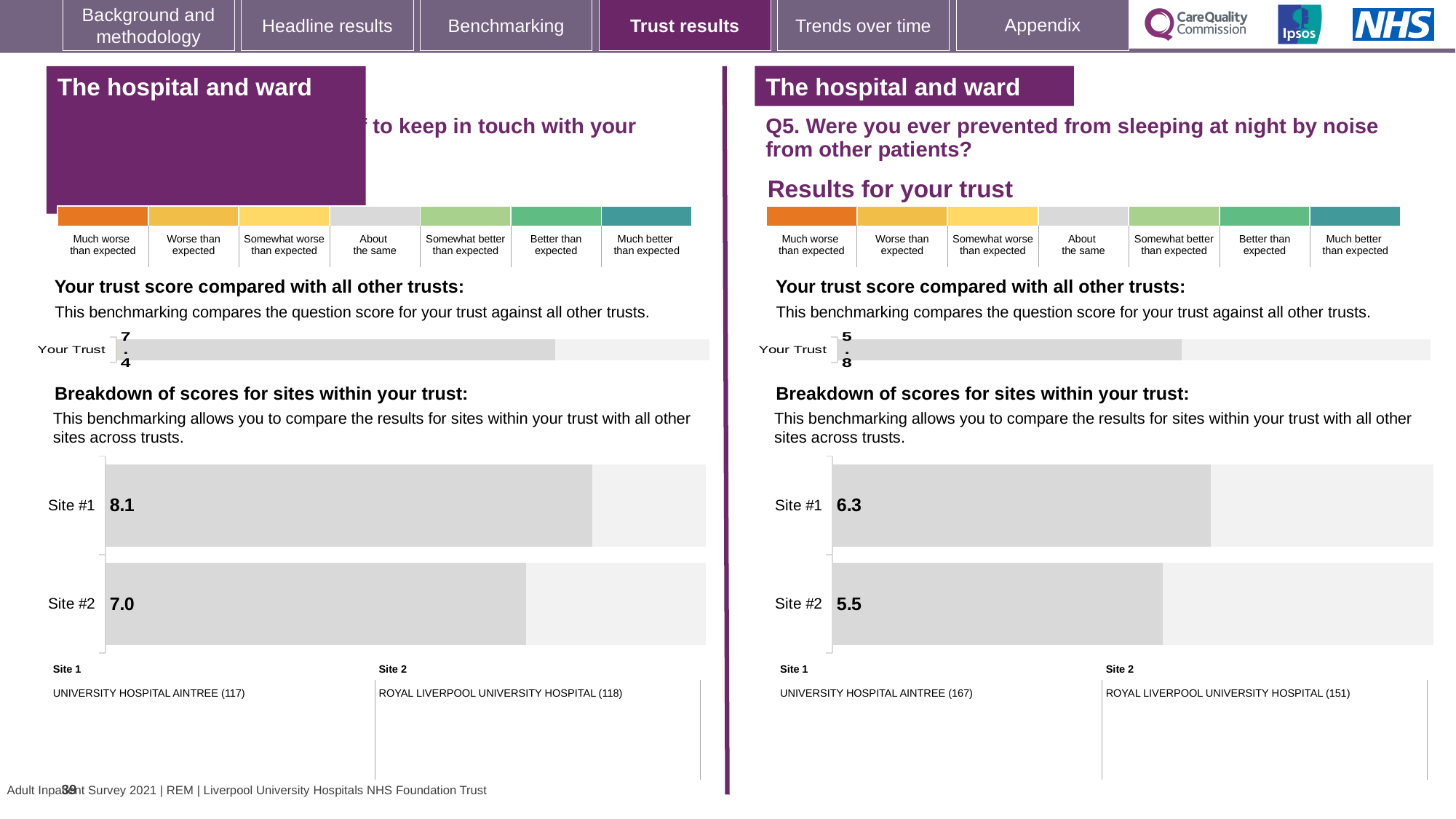
On the right-hand side of the slide (Q5), what is the 'Your Trust' score? 5.8 On the left-hand site breakdown chart, what is the difference between the Site #1 and Site #2 scores? 1.1 On the right-hand chart for Q5, what is the score for Site #2? 5.5 What type of chart is used for the site breakdown on the right-hand side of the slide? Bar chart On the left-hand side of the slide, what is the 'Your Trust' score? 7.4 On the left-hand site breakdown chart, which site has the lower score? Site #2 On the right-hand chart for Q5, which site has the higher score? Site #1 On the left-hand site breakdown chart, what is the score for Site #2? 7.0 On the right-hand chart for Q5, what is the difference between the Site #1 and Site #2 scores? 0.8 On the left-hand site breakdown chart, what is the score for Site #1? 8.1 On the right-hand chart for Q5 (prevented from sleeping at night by noise from other patients), what is the score for Site #1? 6.3 How many sites are shown in the right-hand site breakdown chart for Q5? 2